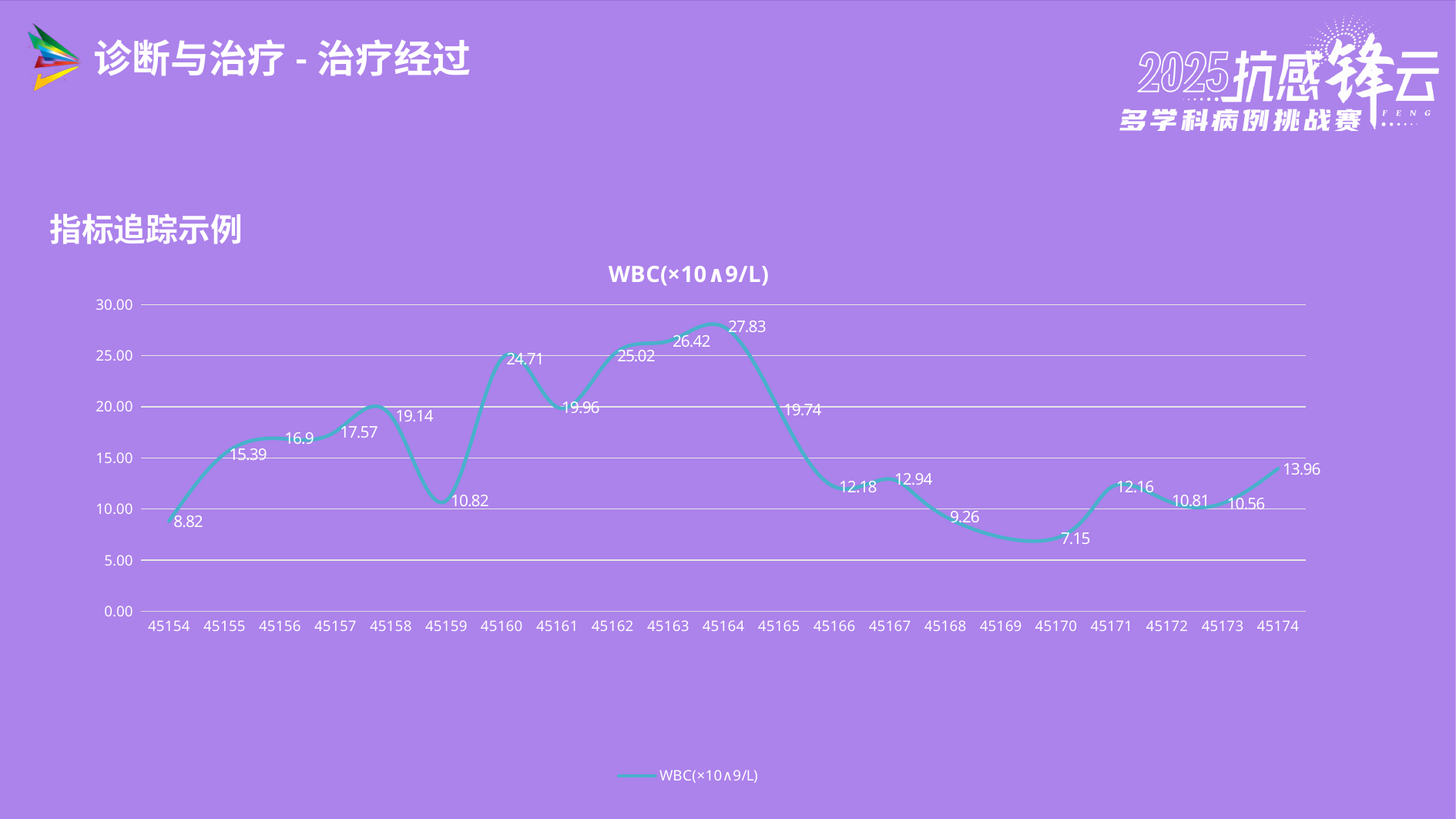
How many dates are labelled on the x axis? 21 What is the difference between the WBC values at 45164 and 45154? 19.01 What is the WBC value at 45154? 8.82 At which x-axis date is the WBC value highest? 45164 Which has the larger WBC value, 45160 or 45161? 45160 What kind of chart is shown on the slide? line chart What is the WBC value at 45164? 27.83 What is the WBC value at 45174? 13.96 What is the title of the chart? WBC(×10∧9/L) Do the WBC values rise or fall from 45164 to 45170? fall How many series does the legend list? 1